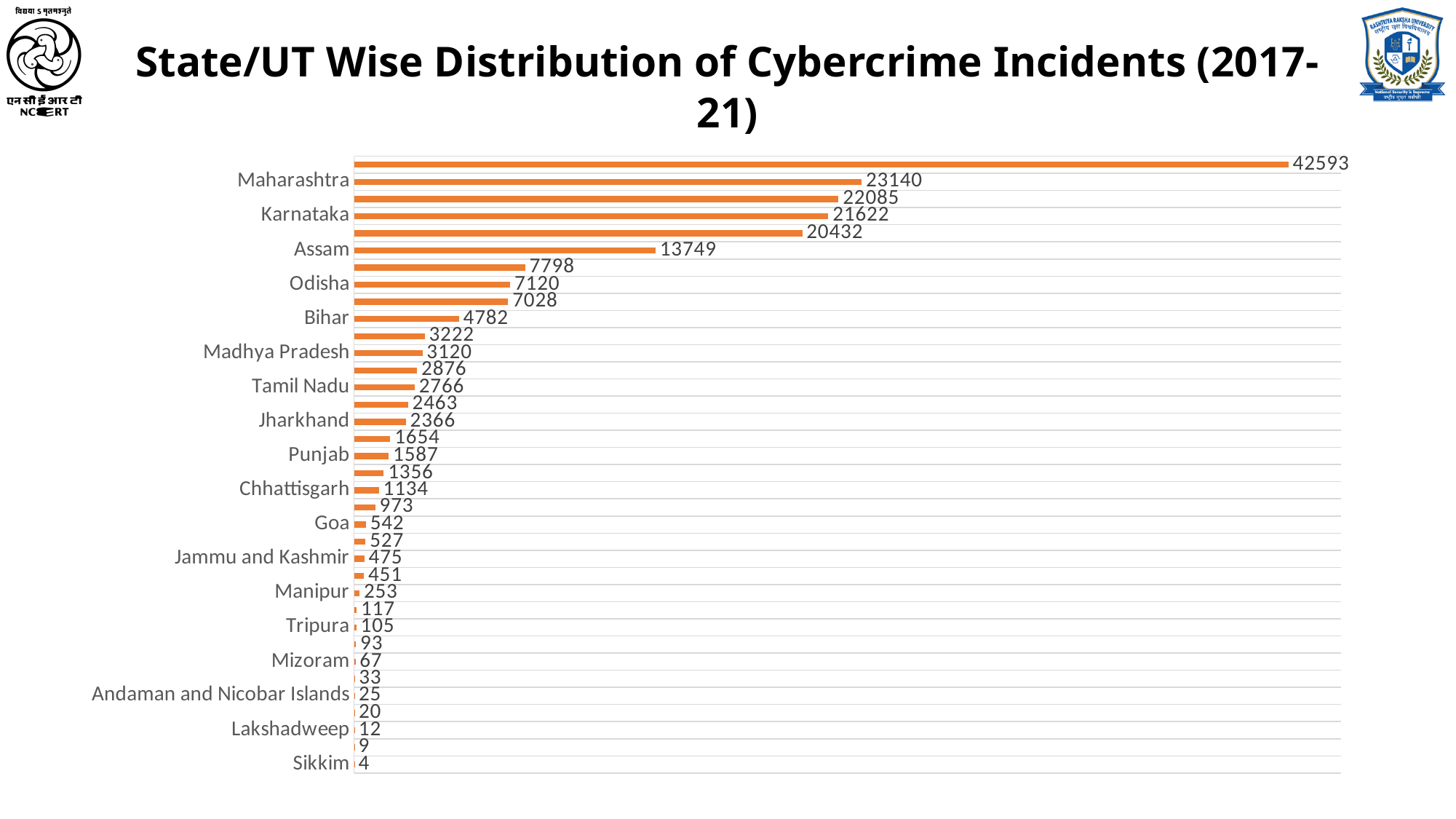
What is the title of the chart? State/UT Wise Distribution of Cybercrime Incidents (2017-21) What is the difference between the values for Maharashtra and Karnataka? 1518 How many bars are plotted on the chart? 36 What is the value shown for Goa? 542 What is the value shown for Assam? 13749 Which has a larger value, Assam or Odisha? Assam What kind of chart is shown on the slide? Bar chart What is the value shown for Karnataka? 21622 Which labelled state/UT has the lowest value on the chart? Sikkim What is the largest value shown on the chart? 42593 What is the value shown for Maharashtra? 23140 What is the value shown for Sikkim? 4